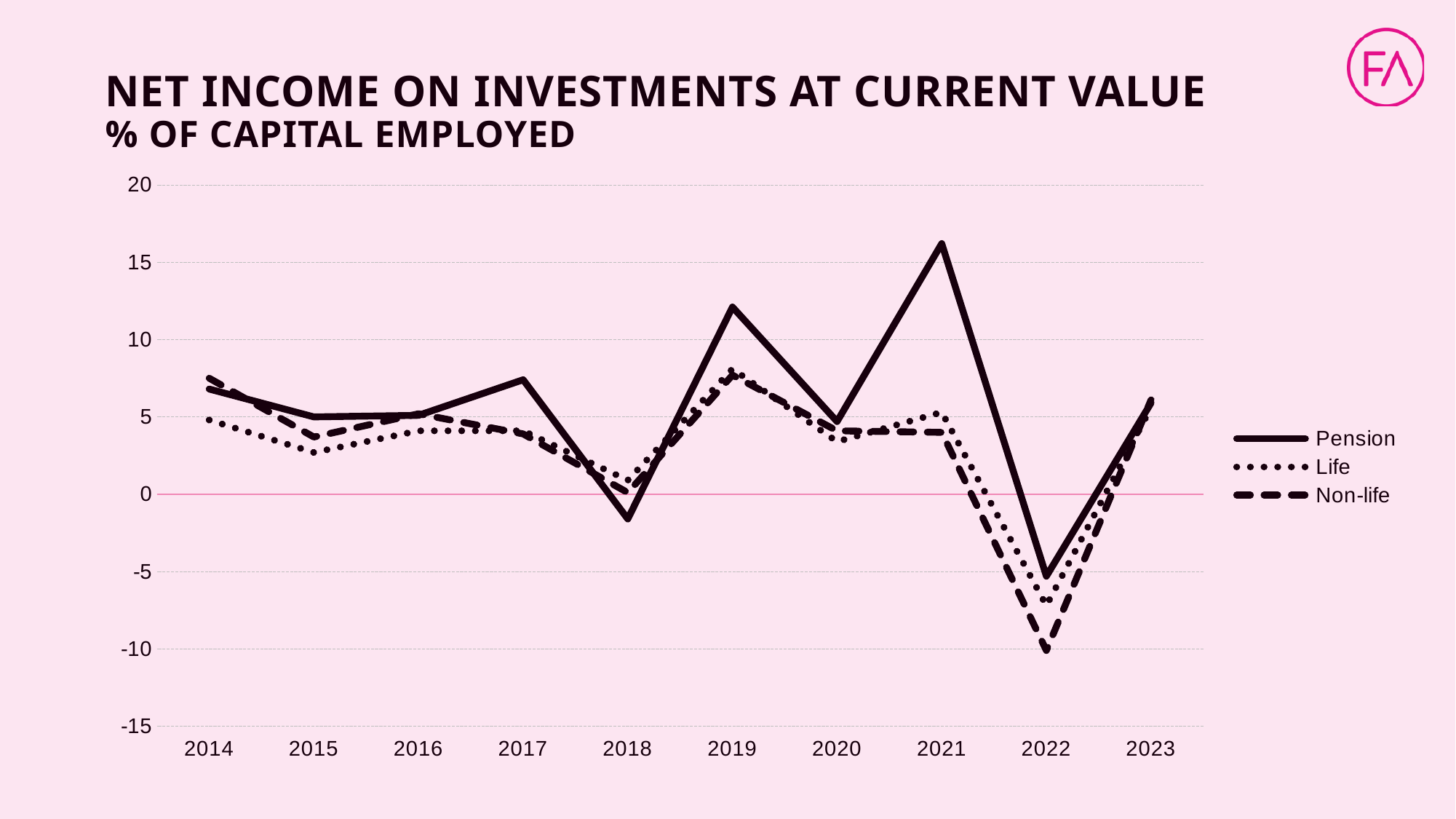
Is the value for Non-life in 2022 greater or less than -5? less How many years are shown on the x axis? 10 Which line style does the legend use for the Non-life series? dashed Does the Pension series rise or fall from 2021 to 2022? fall In which year does the Pension series reach its lowest value? 2022 In which year does the Pension series reach its highest value? 2021 In 2021, which series has the larger value, Pension or Life? Pension Is the value for Pension in 2019 greater or less than 10? greater In which year does the Non-life series reach its lowest value? 2022 What kind of chart is shown on the slide? line chart How many series does the legend list? 3 Is the value for Pension in 2021 greater or less than 15? greater